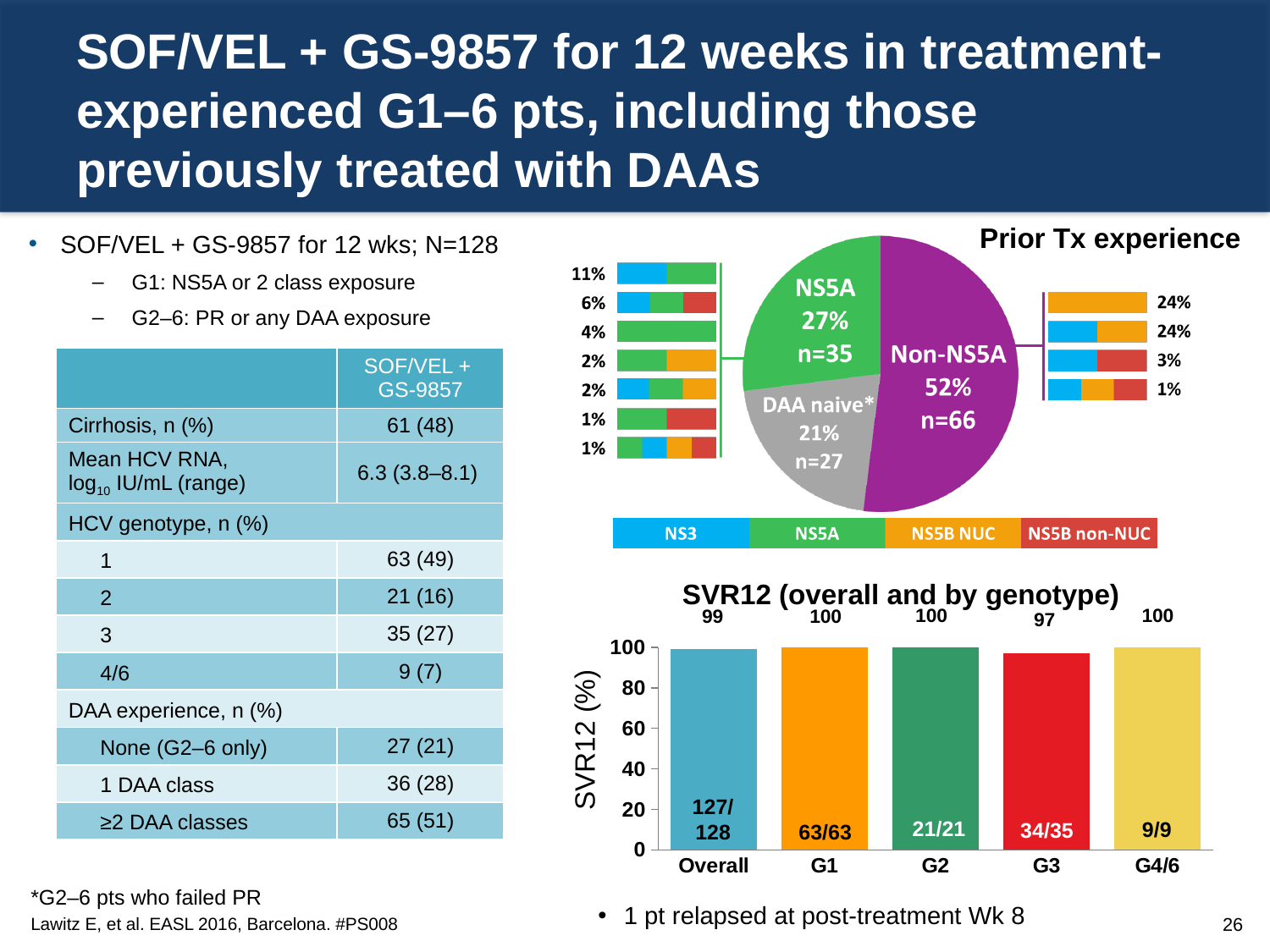
In the SVR12 (overall and by genotype) chart, what fraction is printed on the G2 bar? 21/21 What kind of chart is the SVR12 (overall and by genotype) chart? Bar chart In the SVR12 (overall and by genotype) chart, what is the SVR12 value for Overall? 99 In the SVR12 (overall and by genotype) chart, what is the SVR12 value for G3? 97 In the SVR12 (overall and by genotype) chart, how many bars are shown? 5 In the SVR12 (overall and by genotype) chart, is the SVR12 for Overall greater or less than 80? greater In the Prior Tx experience pie chart, what share of patients is Non-NS5A? 52% In the Prior Tx experience pie chart, which slice is the smallest? DAA naive* In the SVR12 (overall and by genotype) chart, which genotype group has the lowest SVR12? G3 In the Prior Tx experience pie chart, how many patients are in the NS5A slice? n=35 In the Prior Tx experience chart, how many entries does the legend list? 4 In the SVR12 (overall and by genotype) chart, what is the difference between the SVR12 for G1 and for G3? 3